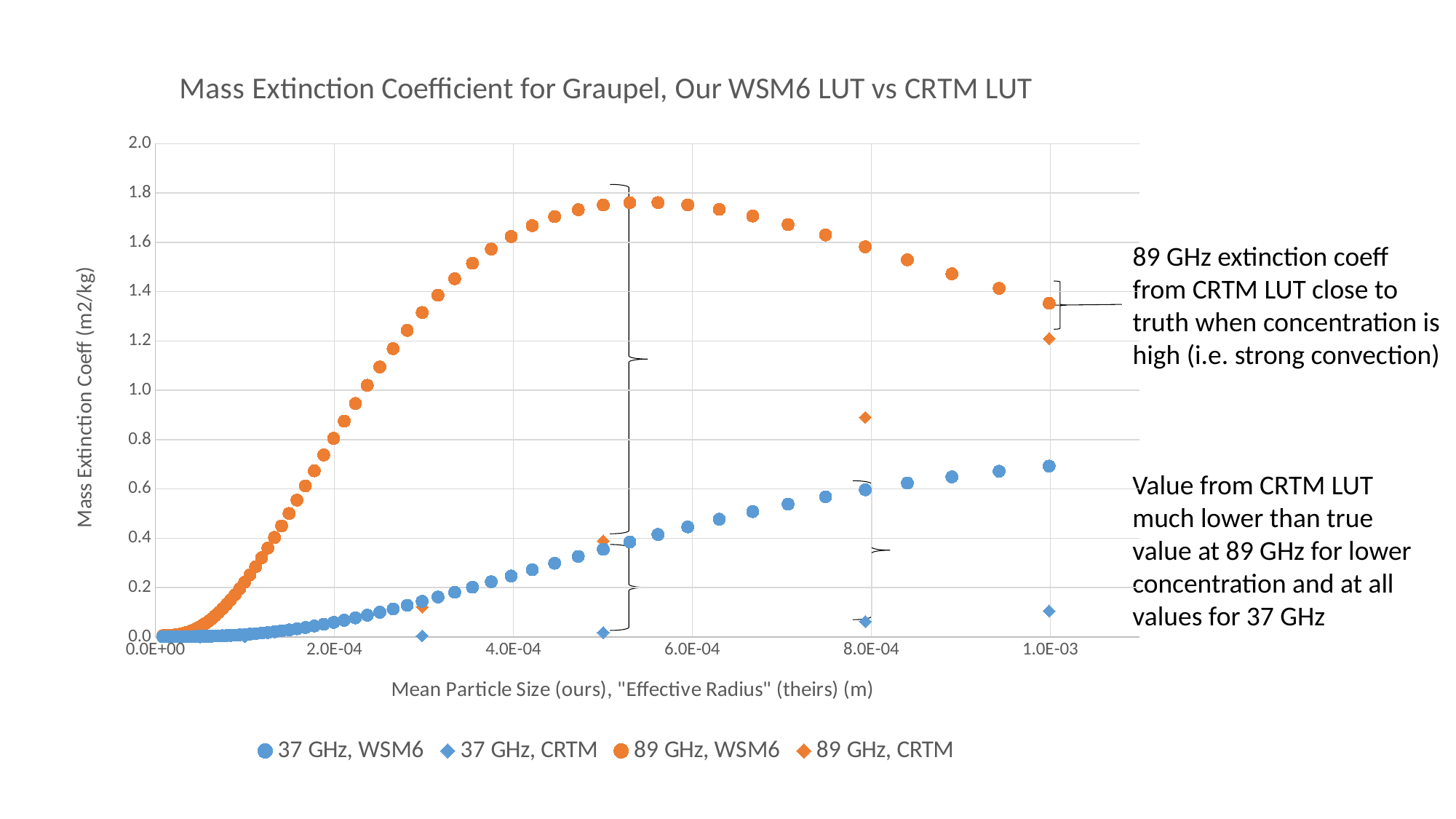
Is the value of the 89 GHz, WSM6 series at 1.0E-03 greater or less than 1.2? greater What is the title of the chart? Mass Extinction Coefficient for Graupel, Our WSM6 LUT vs CRTM LUT What kind of chart is shown on the slide? scatter chart How many series does the legend list? 4 Is the value of the 89 GHz, CRTM series at 8.0E-04 greater or less than 1.0? less Which series reaches the highest mass extinction coefficient on the chart? 89 GHz, WSM6 Is the peak value of the 89 GHz, WSM6 series greater or less than 1.6? greater At 1.0E-03, which is larger: the 89 GHz, WSM6 value or the 89 GHz, CRTM value? 89 GHz, WSM6 What is the label of the y axis? Mass Extinction Coeff (m2/kg) At 8.0E-04, which is larger: the 37 GHz, WSM6 value or the 37 GHz, CRTM value? 37 GHz, WSM6